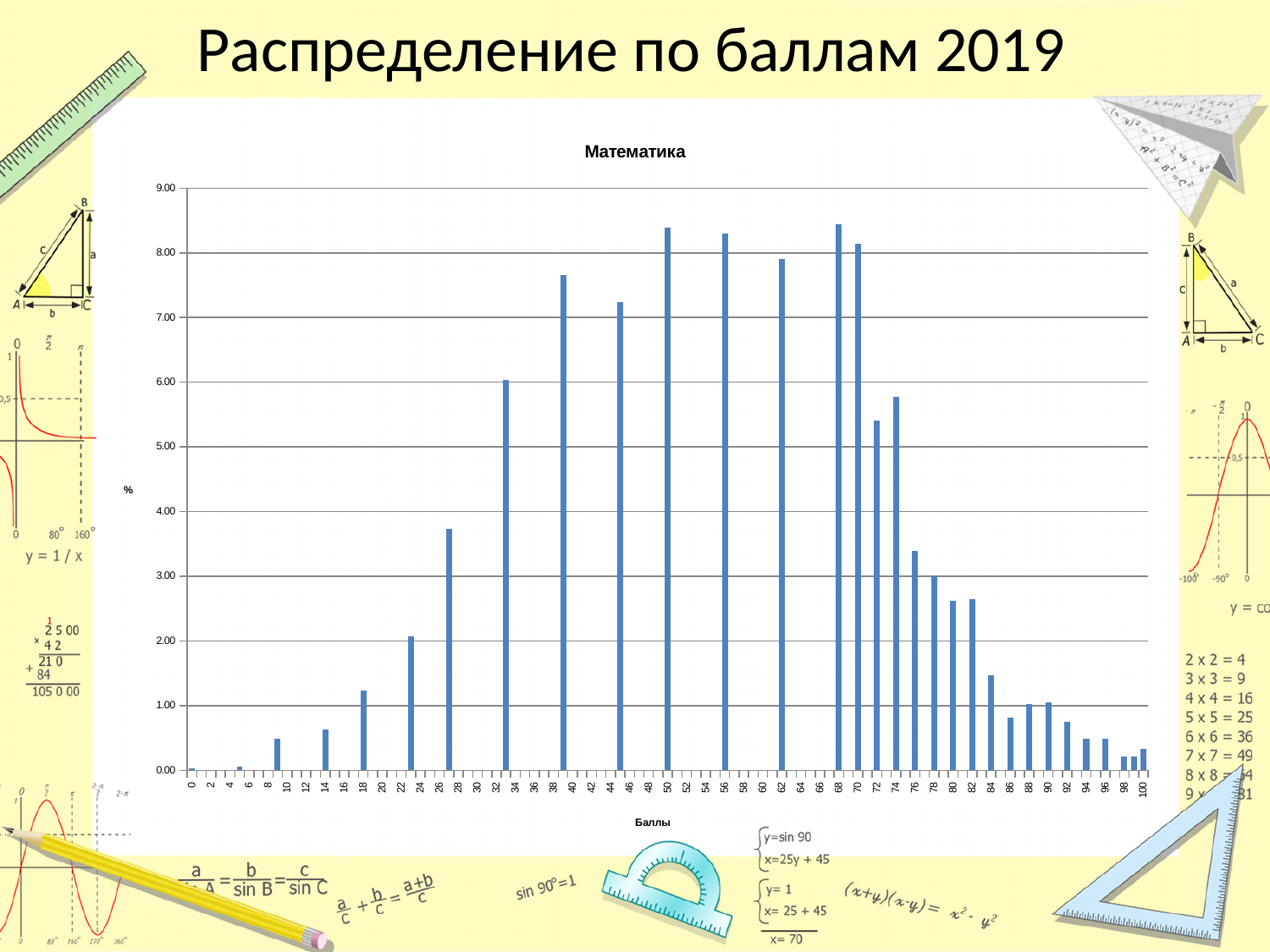
What kind of chart is shown on the slide? bar chart Which is larger, the value for score 72 or the value for score 76? score 72 Do the values generally rise or fall as the score goes from 70 to 100? fall Is the value for score 100 greater or less than 1.00? less What is the title of the chart? Математика Is the value for score 72 greater or less than 5.00? greater What is the label of the horizontal axis of the chart? Баллы Is the value for score 27 greater or less than 3.00? greater Which is larger, the value for score 33 or the value for score 27? score 33